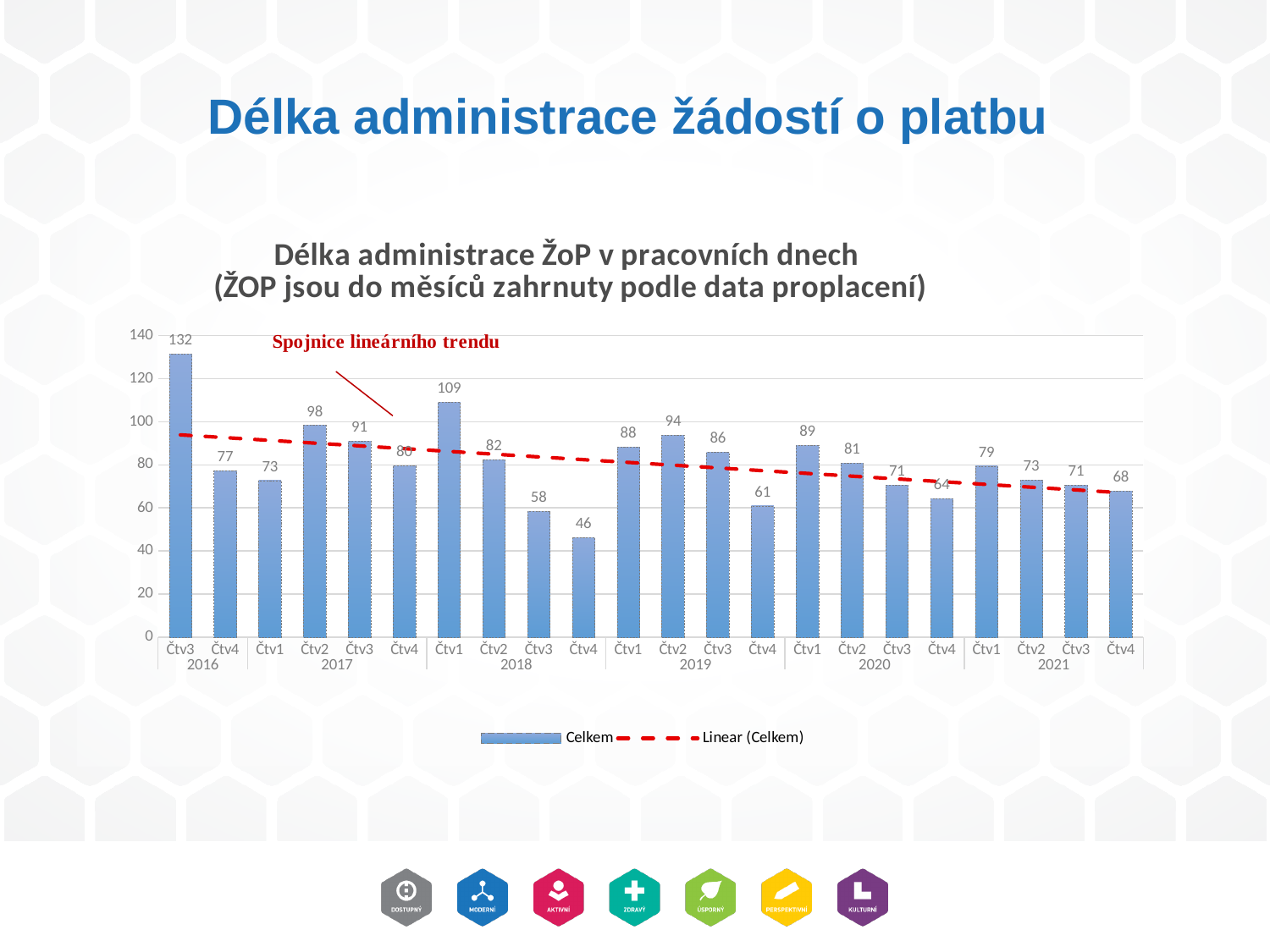
What kind of chart is shown on the slide? bar chart What is the value for Čtv4 2018? 46 What is the difference between the values for Čtv2 2017 and Čtv3 2017? 7 Is the value for Čtv3 2018 greater or less than 60? less What is the value for Čtv4 2021? 68 How many entries does the legend list? 2 How many bars are plotted in the chart? 22 Which quarter has the highest value? Čtv3 2016 Which quarter has the lowest value? Čtv4 2018 What is the value for Čtv3 2016? 132 Which is larger, the value for Čtv2 2019 or the value for Čtv1 2020? Čtv2 2019 What is the value for Čtv1 2018? 109